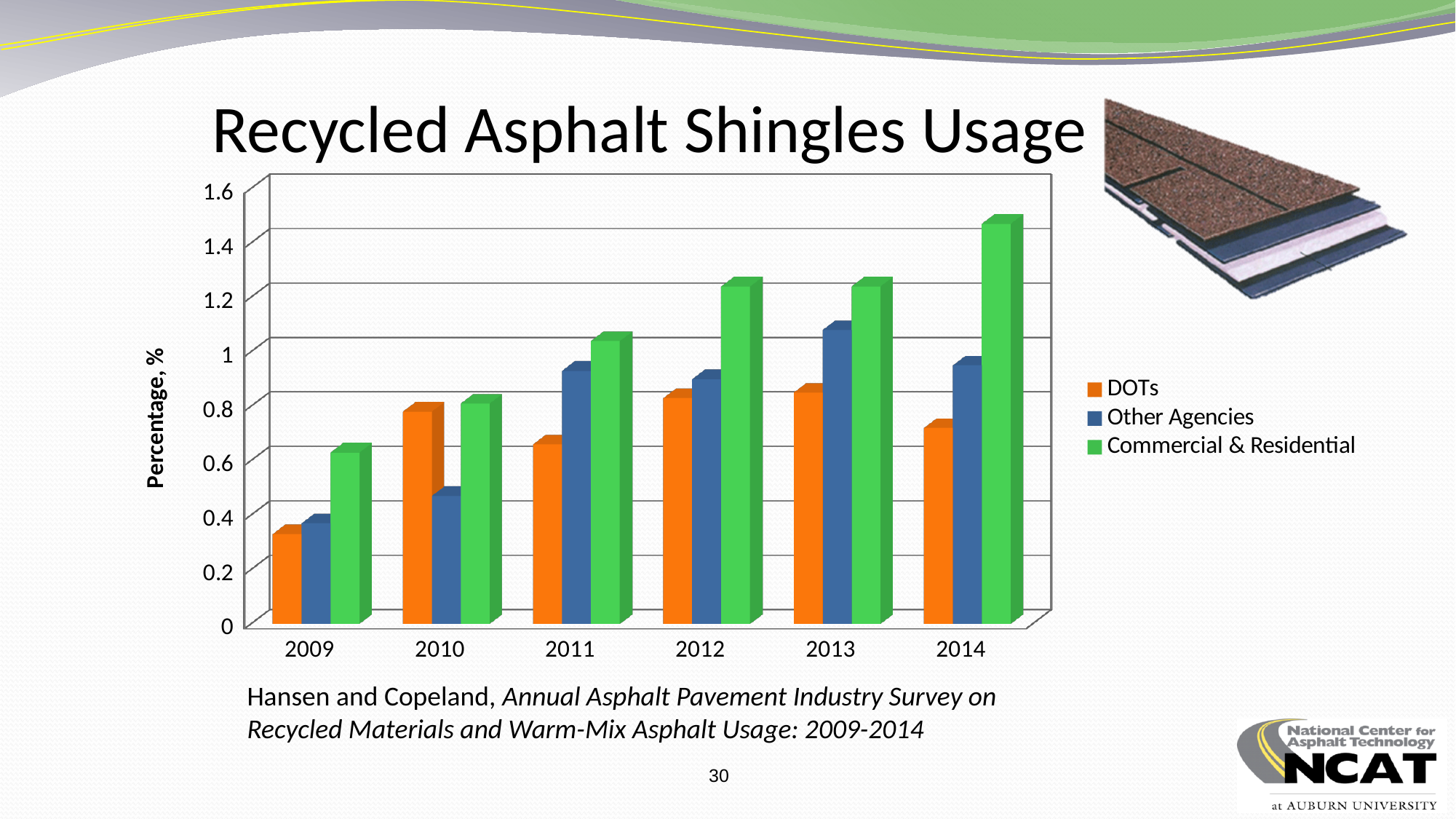
In which year is the Commercial & Residential value highest? 2014 Is the Commercial & Residential value for 2014 greater or less than 1.4? greater Is the DOTs value for 2009 greater or less than 0.4? less Is the Other Agencies value for 2013 greater or less than 1? greater What is the label on the y axis? Percentage, % In 2010, which is larger: the DOTs value or the Other Agencies value? DOTs In which year is the DOTs value lowest? 2009 What kind of chart is shown on the slide? bar chart How many series does the legend list? 3 How many years are shown on the x axis? 6 In 2011, which is larger: the DOTs value or the Other Agencies value? Other Agencies